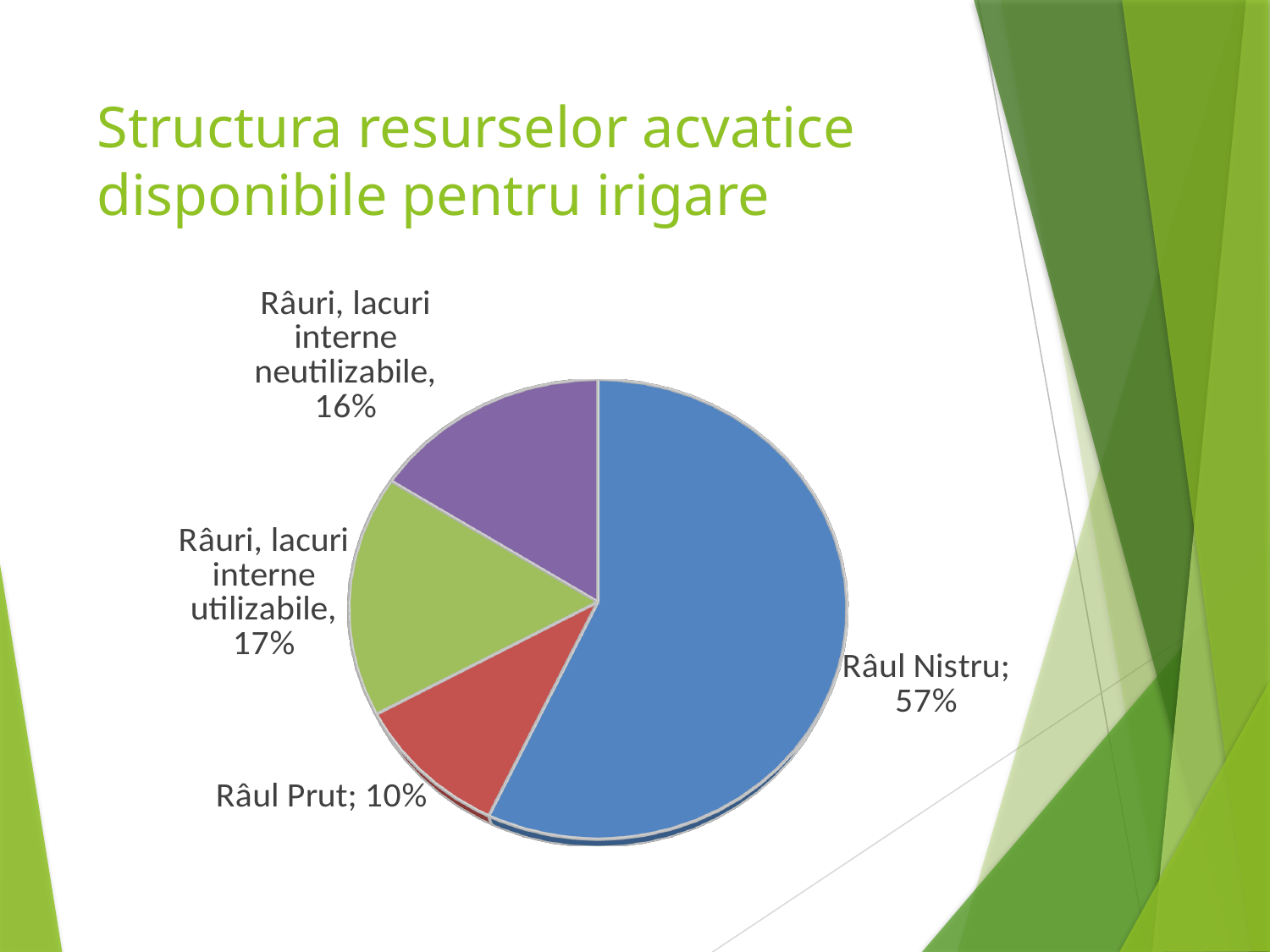
What is the title of the slide containing the chart? Structura resurselor acvatice disponibile pentru irigare What is the value for Râuri, lacuri interne neutilizabile? 16% Which category has the smallest slice of the pie? Râul Prut What share of the pie does Râul Nistru have? 57% What kind of chart is shown on the slide? pie chart How many slices does the pie chart have? 4 Which category has the largest slice of the pie? Râul Nistru What share of the pie does Râul Prut have? 10% What is the value for Râuri, lacuri interne utilizabile? 17% What is the difference between the shares of Râul Nistru and Râul Prut? 47% What is the combined share of Râuri, lacuri interne utilizabile and Râuri, lacuri interne neutilizabile? 33% Which is larger, the share for Râul Nistru or the share for Râuri, lacuri interne utilizabile? Râul Nistru